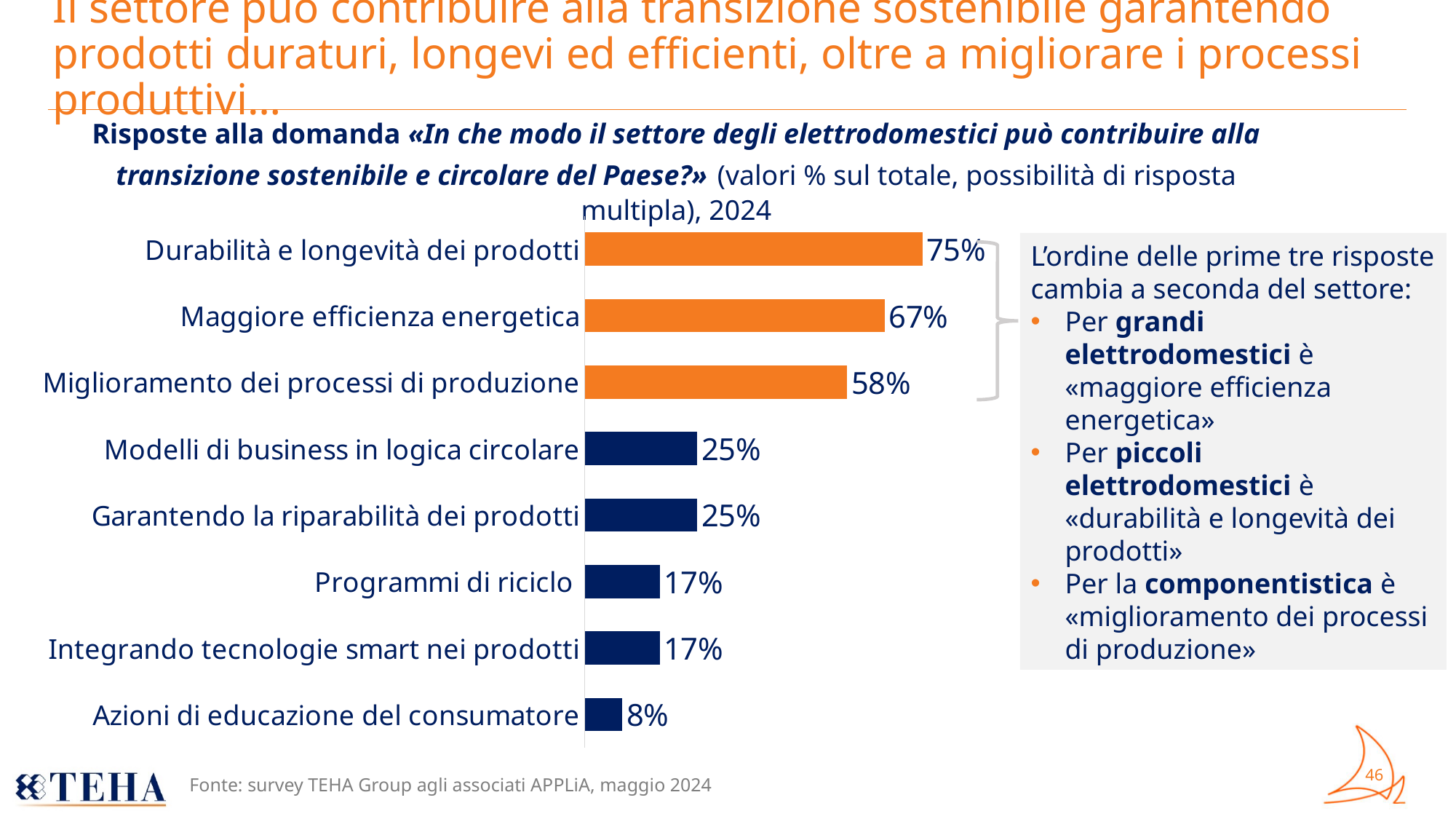
What is the value for "Durabilità e longevità dei prodotti"? 75% What is the value for "Miglioramento dei processi di produzione"? 58% Which category has the lowest value? Azioni di educazione del consumatore What is the difference between the values for "Modelli di business in logica circolare" and "Azioni di educazione del consumatore"? 17% What kind of chart is shown on the slide? Bar chart Which category has the highest value? Durabilità e longevità dei prodotti Which is larger, the value for "Miglioramento dei processi di produzione" or the value for "Garantendo la riparabilità dei prodotti"? Miglioramento dei processi di produzione What is the difference between the values for "Durabilità e longevità dei prodotti" and "Maggiore efficienza energetica"? 8% What is the value for "Maggiore efficienza energetica"? 67% What is the value for "Programmi di riciclo"? 17% How many categories are shown in the chart? 8 How many bars are coloured orange in the chart? 3